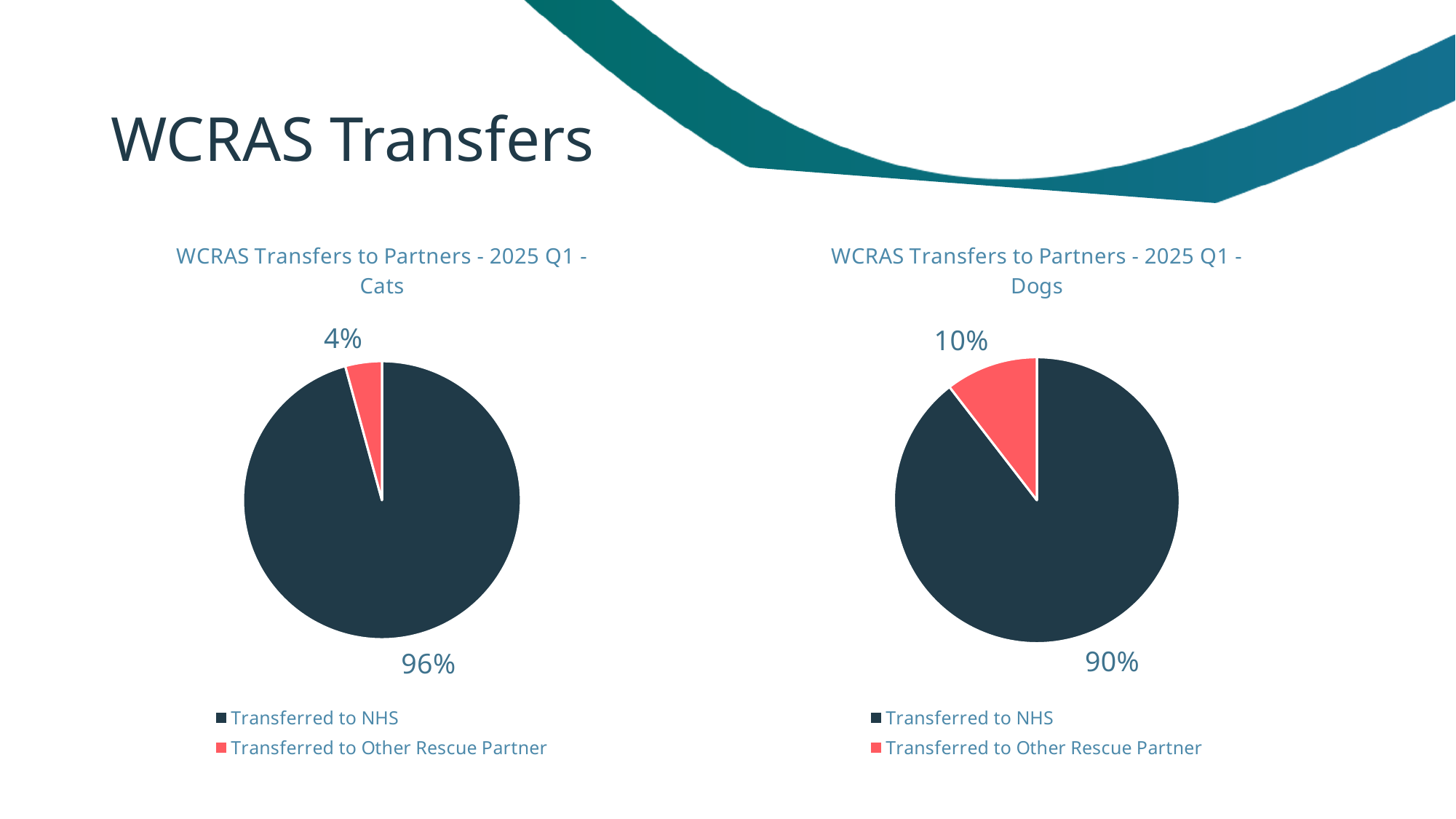
In the 'WCRAS Transfers to Partners - 2025 Q1 - Dogs' chart, what is the difference between the NHS share and the Other Rescue Partner share? 80% In the 'WCRAS Transfers to Partners - 2025 Q1 - Dogs' chart, which category has the smallest slice? Transferred to Other Rescue Partner In the 'WCRAS Transfers to Partners - 2025 Q1 - Dogs' chart, what share of transfers went to Other Rescue Partner? 10% How many categories does the 'WCRAS Transfers to Partners - 2025 Q1 - Cats' chart show? 2 In the 'WCRAS Transfers to Partners - 2025 Q1 - Cats' chart, which category has the largest slice? Transferred to NHS In the 'WCRAS Transfers to Partners - 2025 Q1 - Dogs' chart, what share of transfers went to the NHS? 90% In the 'WCRAS Transfers to Partners - 2025 Q1 - Cats' chart, what share of transfers went to Other Rescue Partner? 4% Which chart shows a larger share transferred to Other Rescue Partner, the Cats chart or the Dogs chart? Dogs In the 'WCRAS Transfers to Partners - 2025 Q1 - Dogs' chart, what colour is the 'Transferred to Other Rescue Partner' slice? Red What kind of chart is the 'WCRAS Transfers to Partners - 2025 Q1 - Dogs' chart? Pie chart In the 'WCRAS Transfers to Partners - 2025 Q1 - Cats' chart, what is the difference between the NHS share and the Other Rescue Partner share? 92%